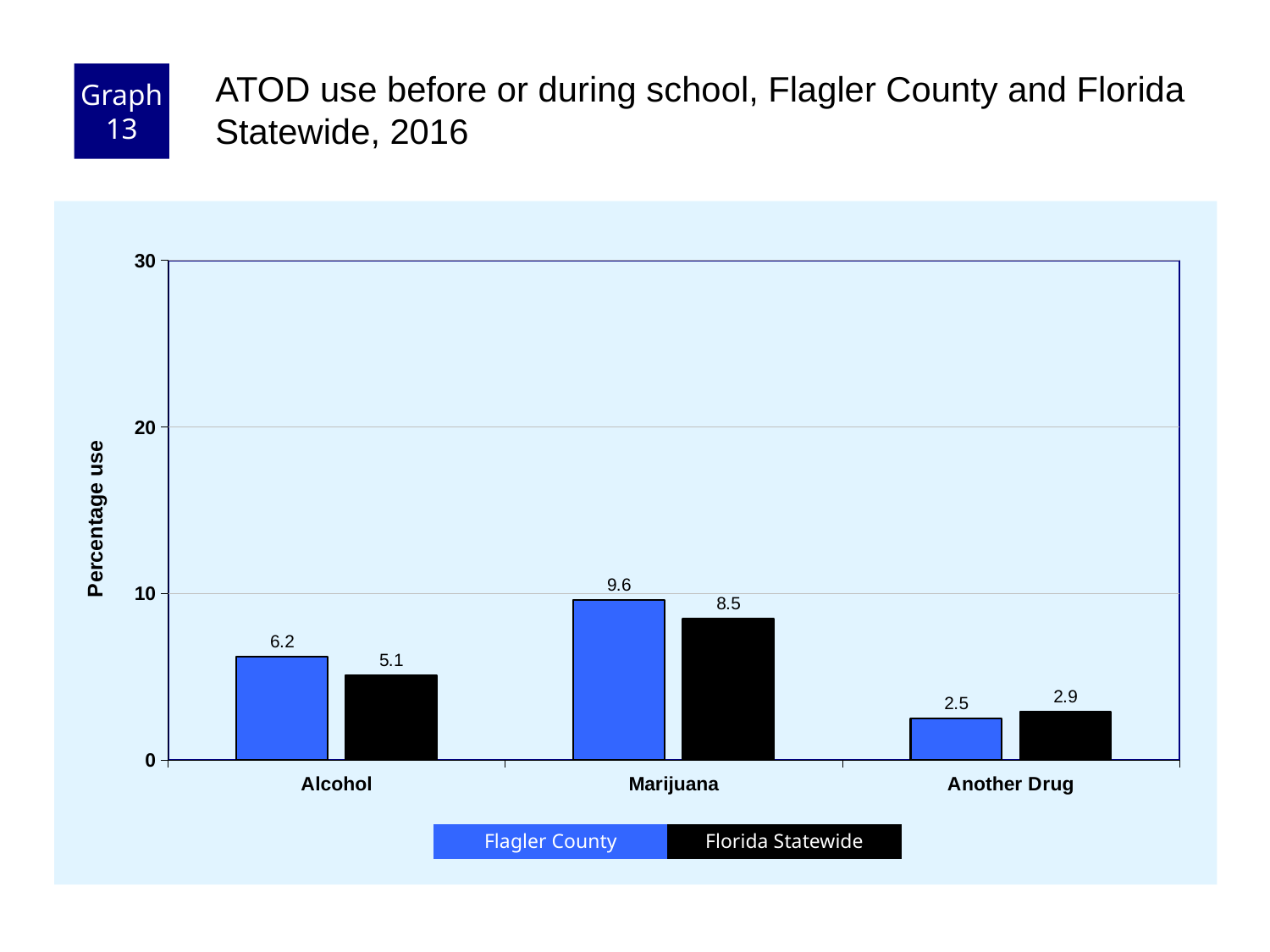
How many series does the legend list? 2 What is the Flagler County value for Marijuana? 9.6 What is the Florida Statewide value for Another Drug? 2.9 Which category has the highest Flagler County value? Marijuana Which category has the lowest Florida Statewide value? Another Drug What is the difference between the Flagler County values for Alcohol and Another Drug? 3.7 How many categories are shown on the x axis? 3 For Another Drug, which is larger: Flagler County or Florida Statewide? Florida Statewide Is the Flagler County value for Marijuana greater or less than 10? less What is the Florida Statewide value for Alcohol? 5.1 What kind of chart is shown on the slide? bar chart What is the difference between the Flagler County and Florida Statewide values for Marijuana? 1.1